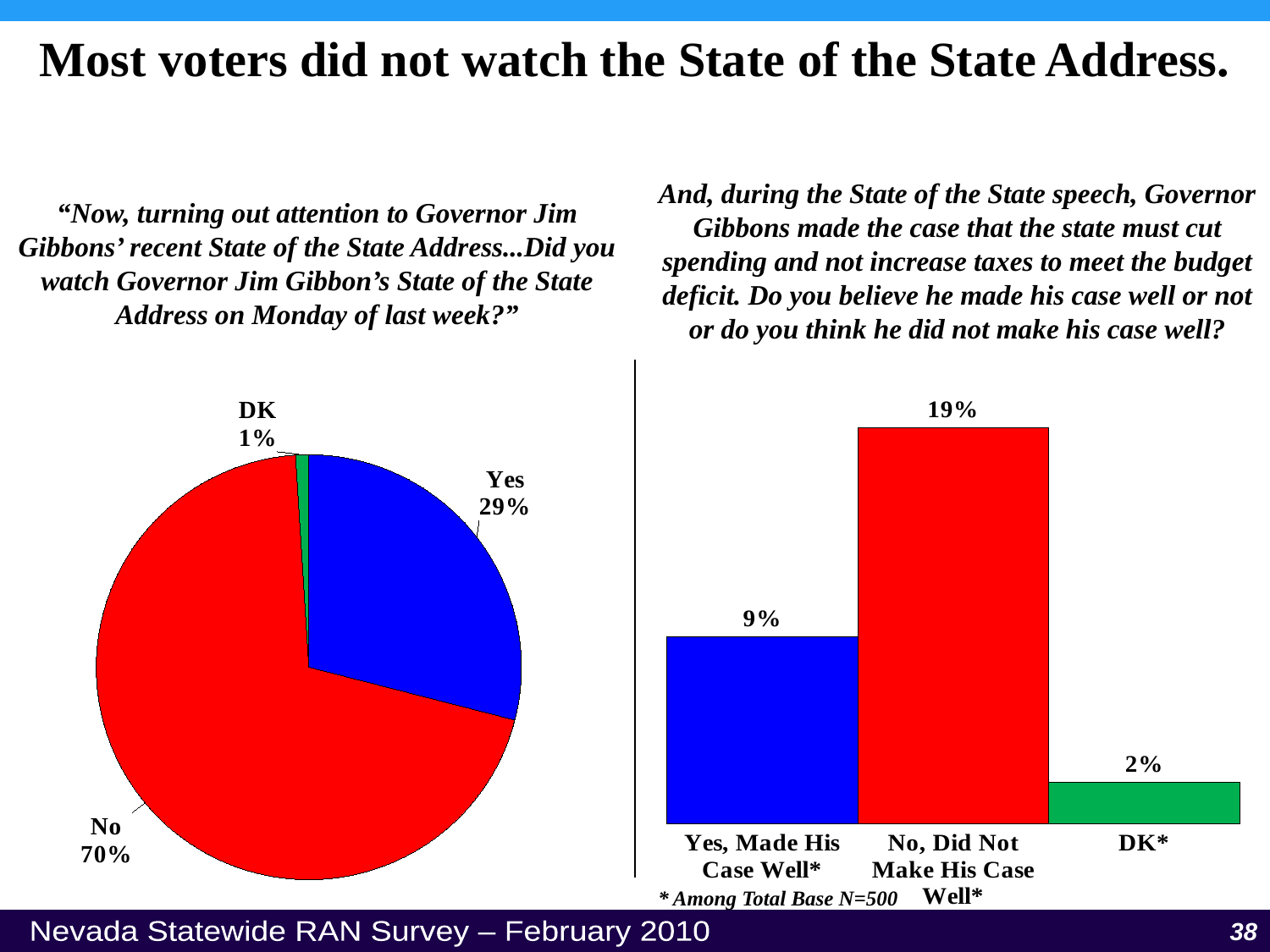
In the pie chart on the left, which response has the smallest slice? DK In the bar chart on the right, what is the value for 'Yes, Made His Case Well*'? 9% In the pie chart on the left, which response has the largest slice? No In the pie chart on the left, what is the difference between the No and Yes percentages? 41% In the bar chart on the right, what is the difference between 'No, Did Not Make His Case Well*' and 'Yes, Made His Case Well*'? 10% In the pie chart on the left, what percentage of voters said No? 70% In the pie chart on the left, what share of the pie is DK? 1% In the pie chart on the left, what percentage of voters said Yes, they watched the State of the State Address? 29% What type of chart is shown on the right side of the slide? Bar chart In the bar chart on the right, which category has the lowest value? DK* In the bar chart on the right, what is the value for 'No, Did Not Make His Case Well*'? 19% In the pie chart on the left, how many slices are there? 3